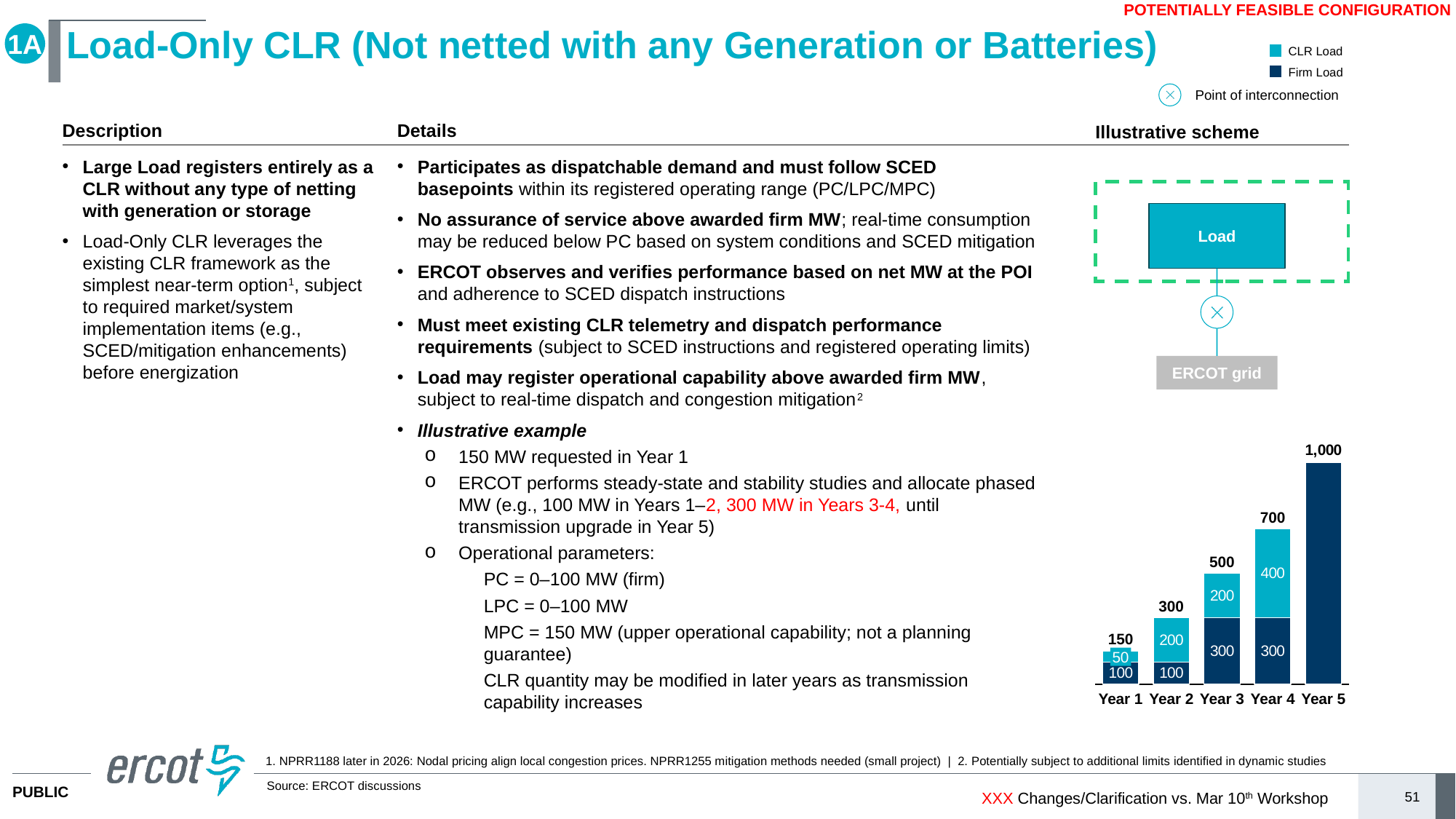
What is the CLR Load value for Year 1? 50 Which is larger, the CLR Load value for Year 4 or the CLR Load value for Year 3? Year 4 How many years are shown on the x axis of the bar chart? 5 How many series does the chart legend list? 2 What is the difference between the total for Year 4 and the total for Year 3? 200 Which year has the highest total bar? Year 5 What is the Firm Load value for Year 4? 300 What is the CLR Load value for Year 2? 200 Do the total bar values rise or fall from Year 1 to Year 5? Rise What kind of chart is shown at the bottom right of the slide? Stacked bar chart Which year has the lowest total bar? Year 1 What is the total value shown above the bar for Year 3? 500